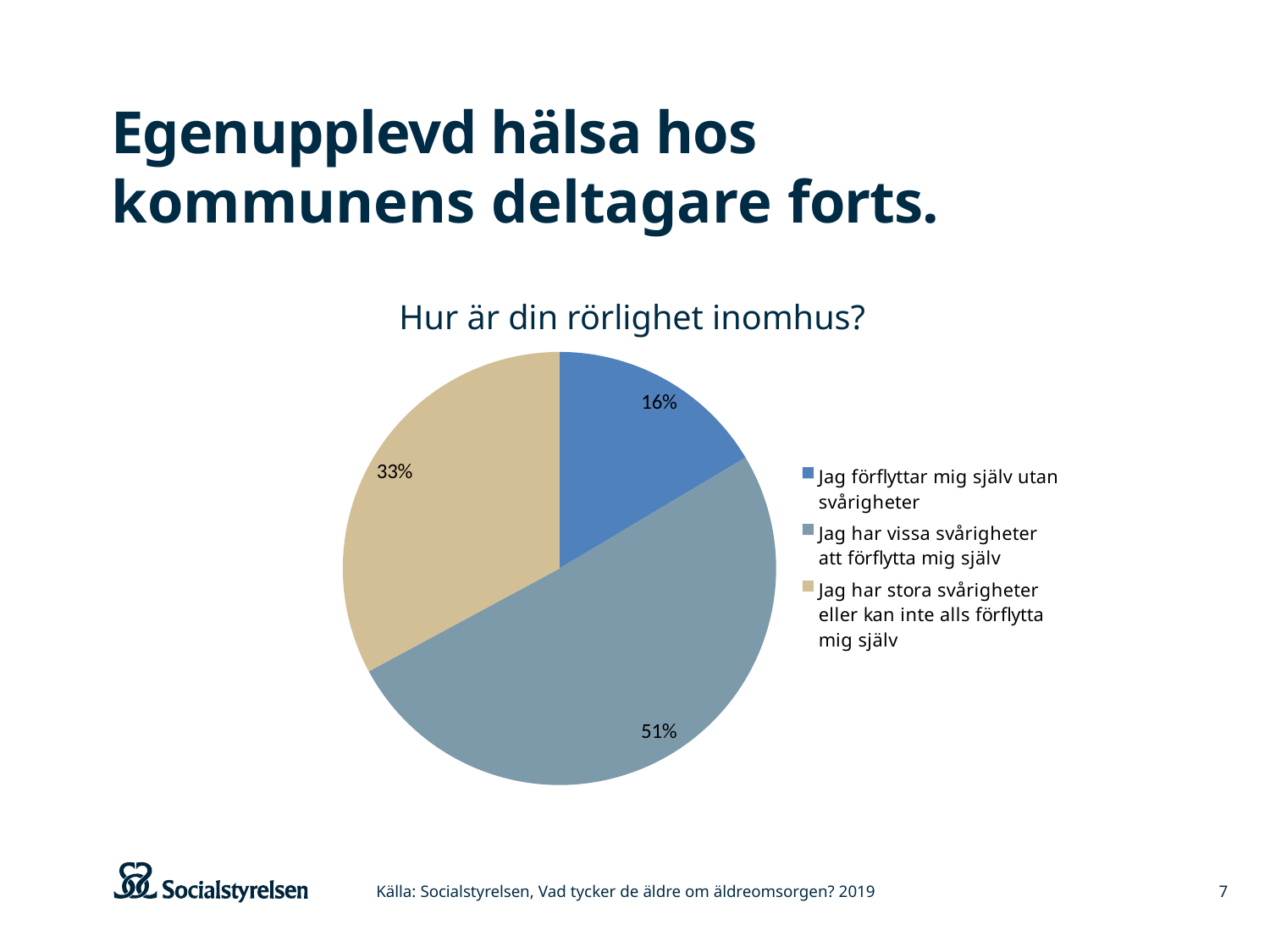
What share of the pie is labelled "Jag har stora svårigheter eller kan inte alls förflytta mig själv"? 33% What is the difference in percentage points between the "Jag har vissa svårigheter att förflytta mig själv" slice and the "Jag har stora svårigheter eller kan inte alls förflytta mig själv" slice? 18 percentage points How many entries does the legend list? 3 What share of the pie is labelled "Jag har vissa svårigheter att förflytta mig själv"? 51% What type of chart is shown on the slide? Pie chart Which category has the largest slice of the pie? Jag har vissa svårigheter att förflytta mig själv How many slices does the pie chart have? 3 What is the title of the chart? Hur är din rörlighet inomhus? Which category has the smallest slice of the pie? Jag förflyttar mig själv utan svårigheter What colour is the slice for "Jag har stora svårigheter eller kan inte alls förflytta mig själv"? Beige What share of the pie is labelled "Jag förflyttar mig själv utan svårigheter"? 16% Which is larger: the share for "Jag har stora svårigheter eller kan inte alls förflytta mig själv" or the share for "Jag förflyttar mig själv utan svårigheter"? Jag har stora svårigheter eller kan inte alls förflytta mig själv